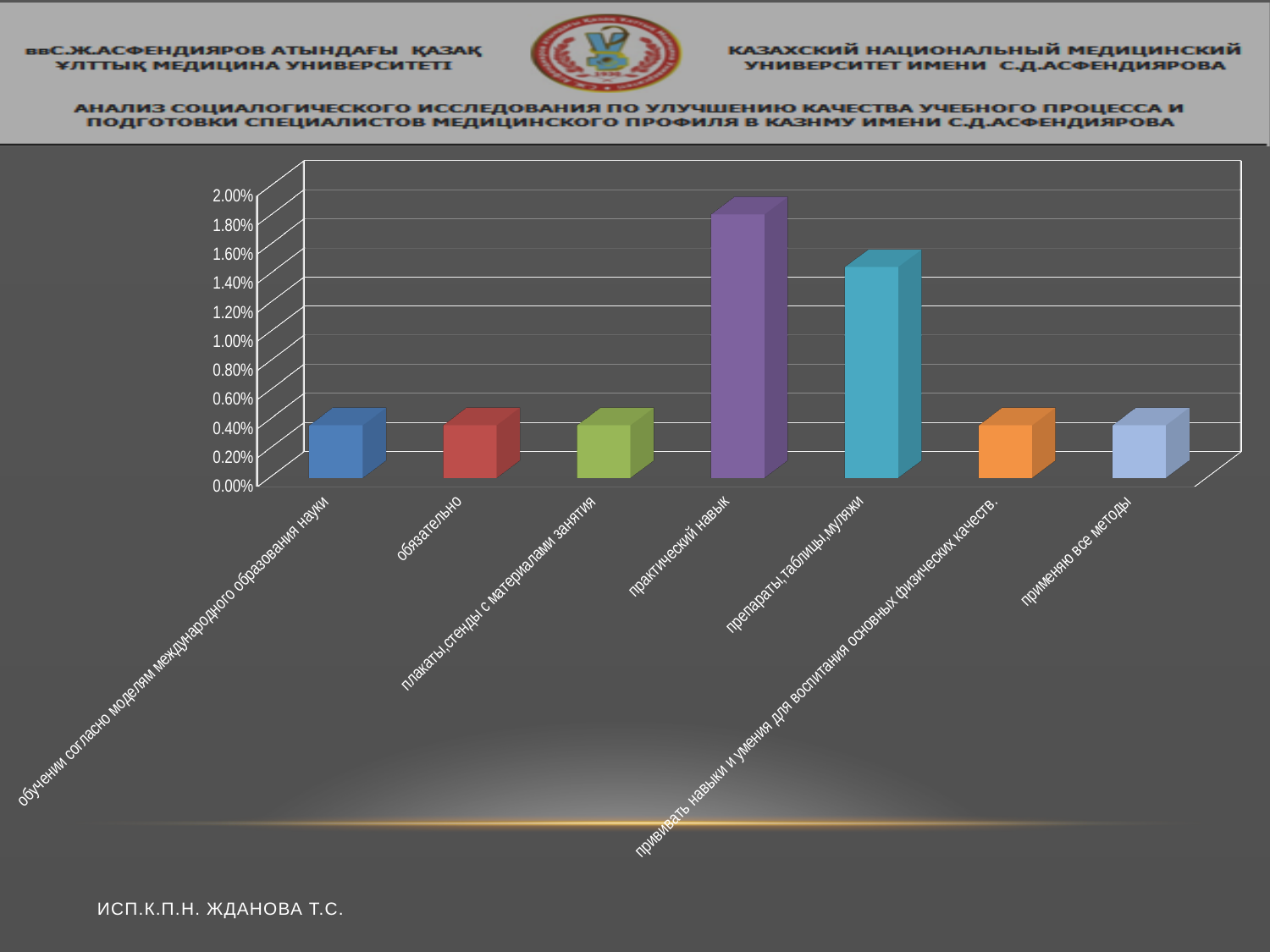
Is the value for практический навык greater or less than 1.00%? greater Is the value for применяю все методы greater or less than 1.00%? less Which is larger, the value for практический навык or the value for препараты,таблицы,муляжи? практический навык What is the highest value shown on the vertical axis of the chart? 2.00% How many categories are plotted on the x axis of the chart? 7 Which is larger, the value for препараты,таблицы,муляжи or the value for применяю все методы? препараты,таблицы,муляжи What kind of chart is shown on the slide? bar chart Is the value for плакаты,стенды с материалами занятия greater or less than 0.80%? less Which category has the highest bar in the chart? практический навык